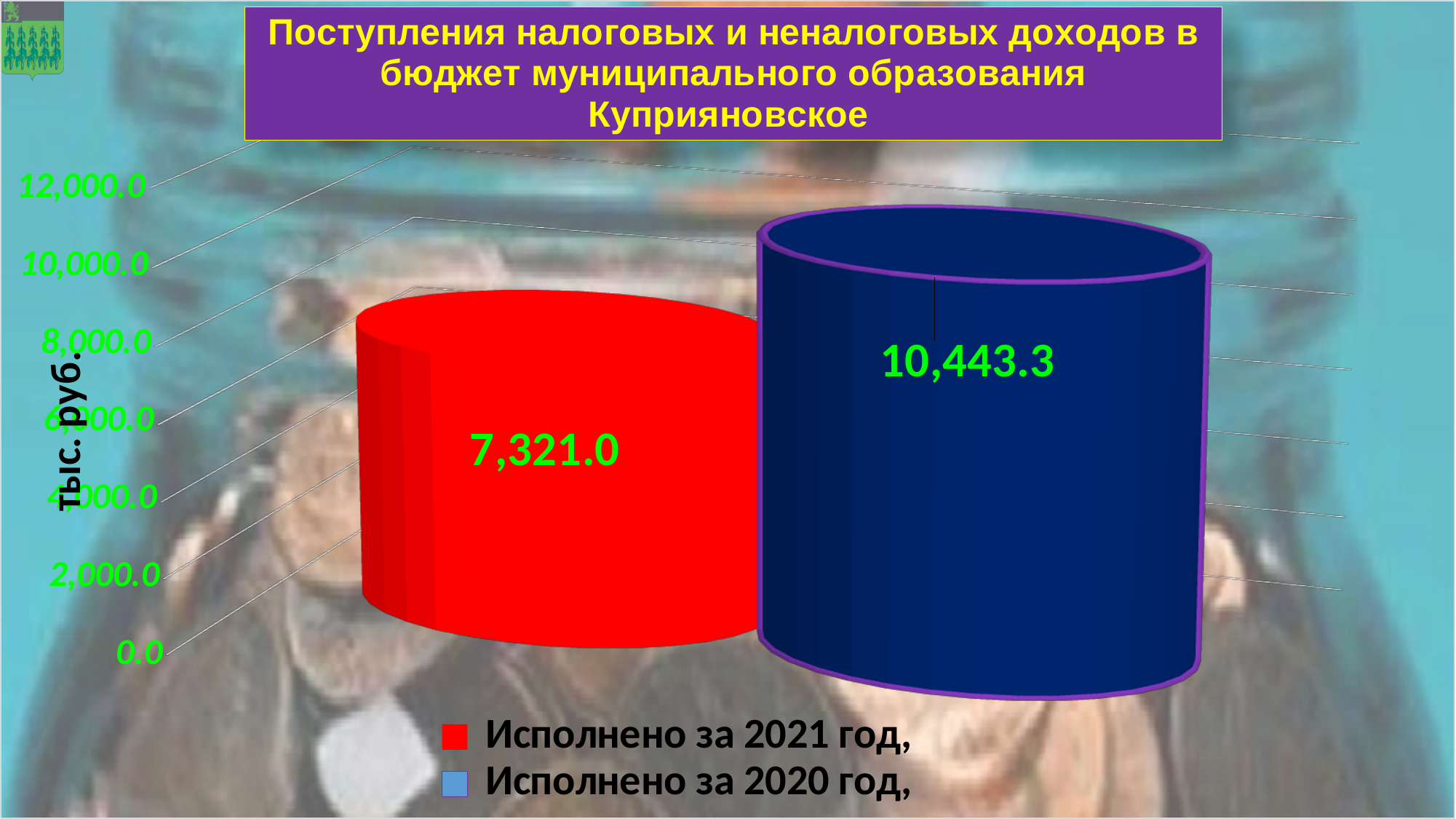
What is the value for "Исполнено за 2021 год"? 7,321.0 How many series does the legend list? 2 What unit is shown on the vertical axis label? тыс. руб. What kind of chart is shown on the slide? bar chart Is the value for "Исполнено за 2020 год" greater or less than 10,000.0? greater Is the value for "Исполнено за 2021 год" greater or less than 8,000.0? less What is the difference between the 2020 value and the 2021 value? 3,122.3 Which series has the higher value, "Исполнено за 2021 год" or "Исполнено за 2020 год"? Исполнено за 2020 год What is the value for "Исполнено за 2020 год"? 10,443.3 What colour is the bar for "Исполнено за 2021 год"? red Which series has the lower value? Исполнено за 2021 год How many bars are plotted on the chart? 2